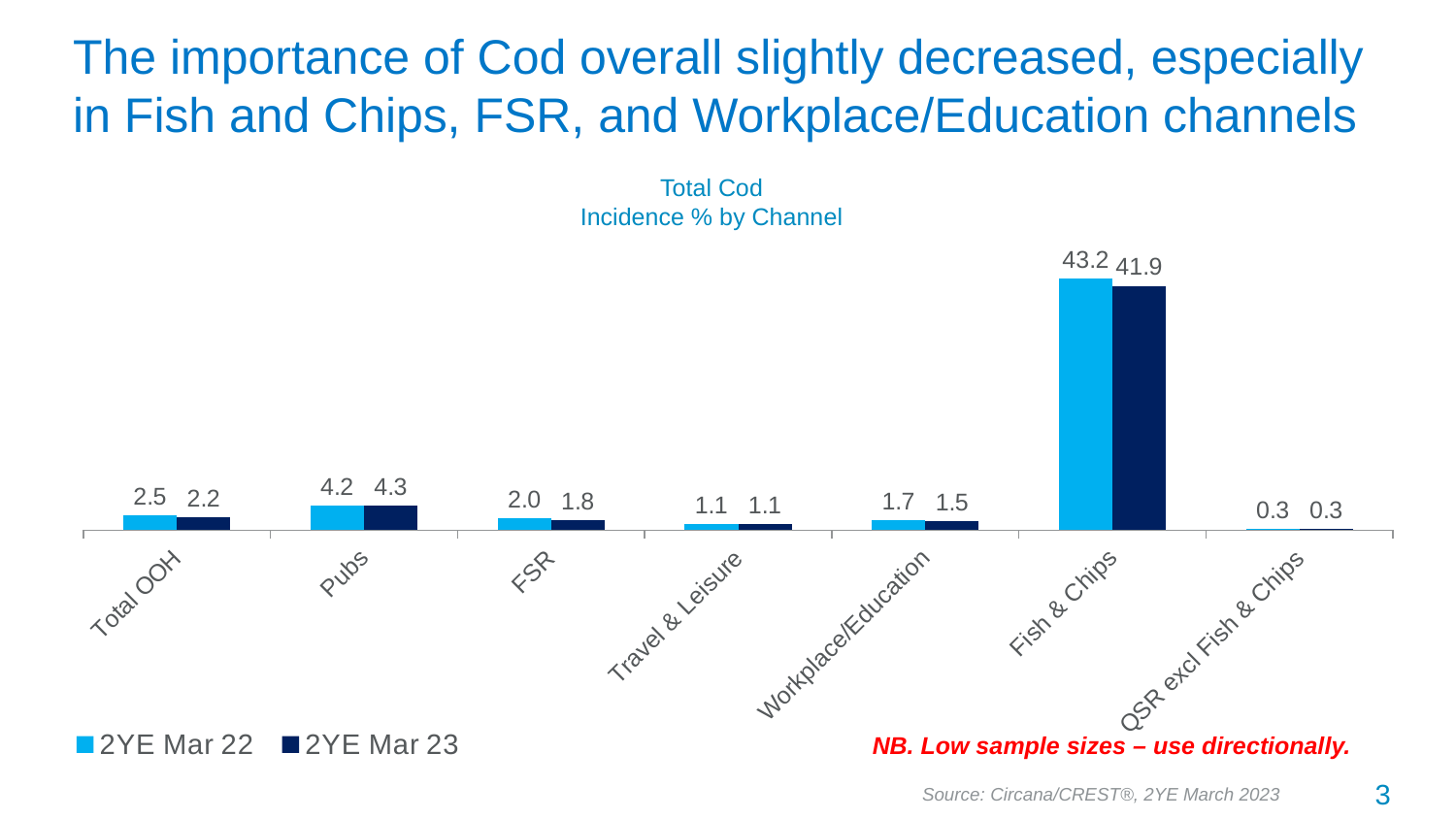
What is the title of the chart? Total Cod Incidence % by Channel What is the difference between the 2YE Mar 22 and 2YE Mar 23 values for Fish & Chips? 1.3 What is the value for Pubs in the 2YE Mar 23 series? 4.3 What is the value for Total OOH in the 2YE Mar 23 series? 2.2 What is the value for Fish & Chips in the 2YE Mar 22 series? 43.2 What kind of chart is shown on the slide? Bar chart How many series does the legend list? 2 Which is larger for FSR: the 2YE Mar 22 value or the 2YE Mar 23 value? 2YE Mar 22 Which channel has the highest value in the 2YE Mar 23 series? Fish & Chips How many channels are shown on the x axis? 7 Which channel has the lowest value in the 2YE Mar 22 series? QSR excl Fish & Chips What is the value for Workplace/Education in the 2YE Mar 22 series? 1.7